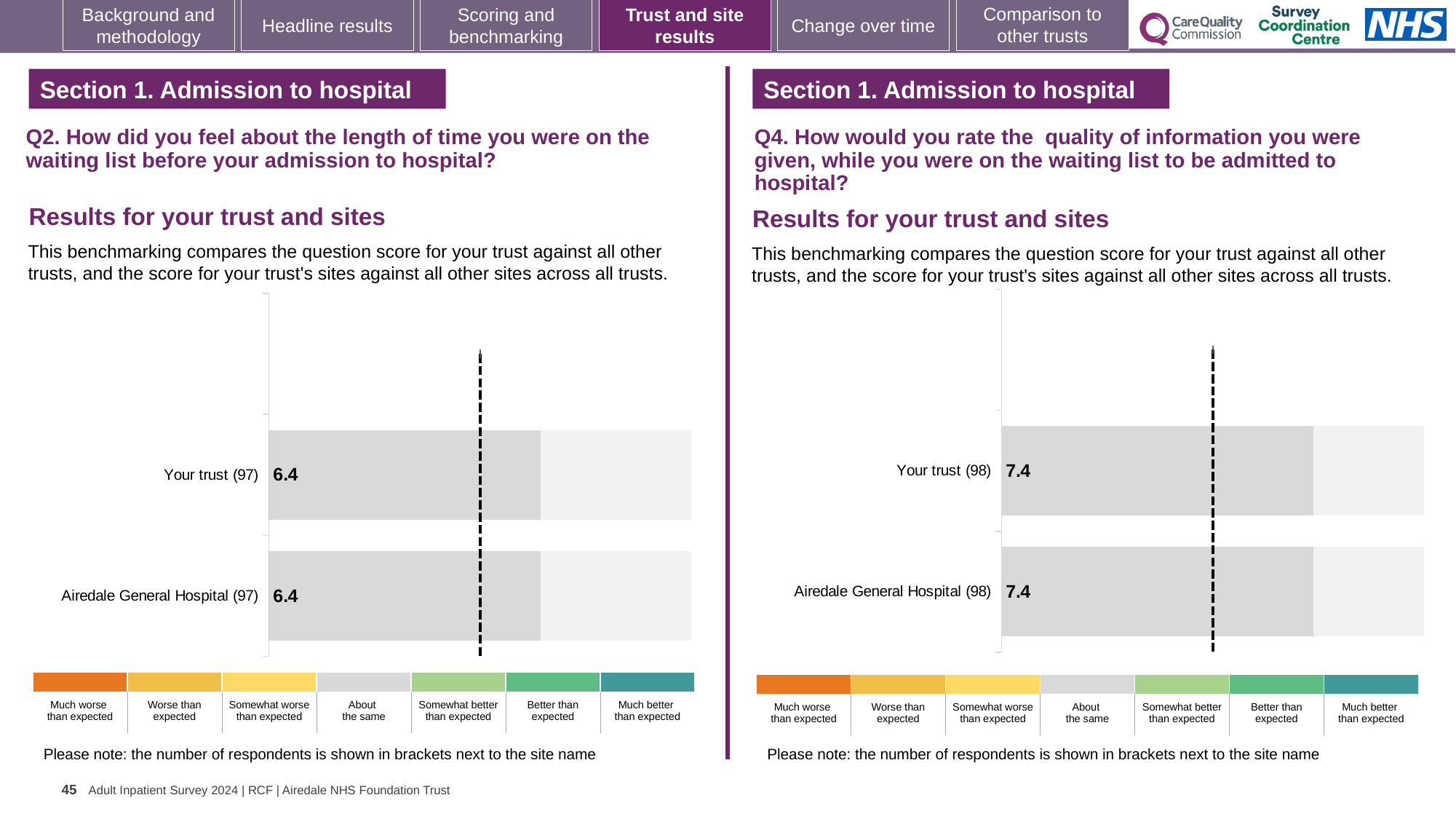
Is the score for Your trust on the Q4 chart (right) larger or smaller than the score for Your trust on the Q2 chart (left)? Larger On the Q2 chart (left), how many respondents are shown in brackets for Your trust? 97 On the Q4 chart (right), what is the score for Airedale General Hospital? 7.4 On the Q2 chart (left), what is the difference between the score for Your trust and the score for Airedale General Hospital? 0 How many bars are plotted on the Q2 chart (left)? 2 What kind of chart is used on the Q2 chart (left)? Bar chart How many bars are plotted on the Q4 chart (right)? 2 On the Q2 chart (left), what is the score for Your trust? 6.4 On the Q4 chart (right), what is the difference between the score for Your trust and the score for Airedale General Hospital? 0 On the Q4 chart (right), how many respondents are shown in brackets for Airedale General Hospital? 98 On the Q2 chart (left), what is the score for Airedale General Hospital? 6.4 On the Q4 chart (right), what is the score for Your trust? 7.4